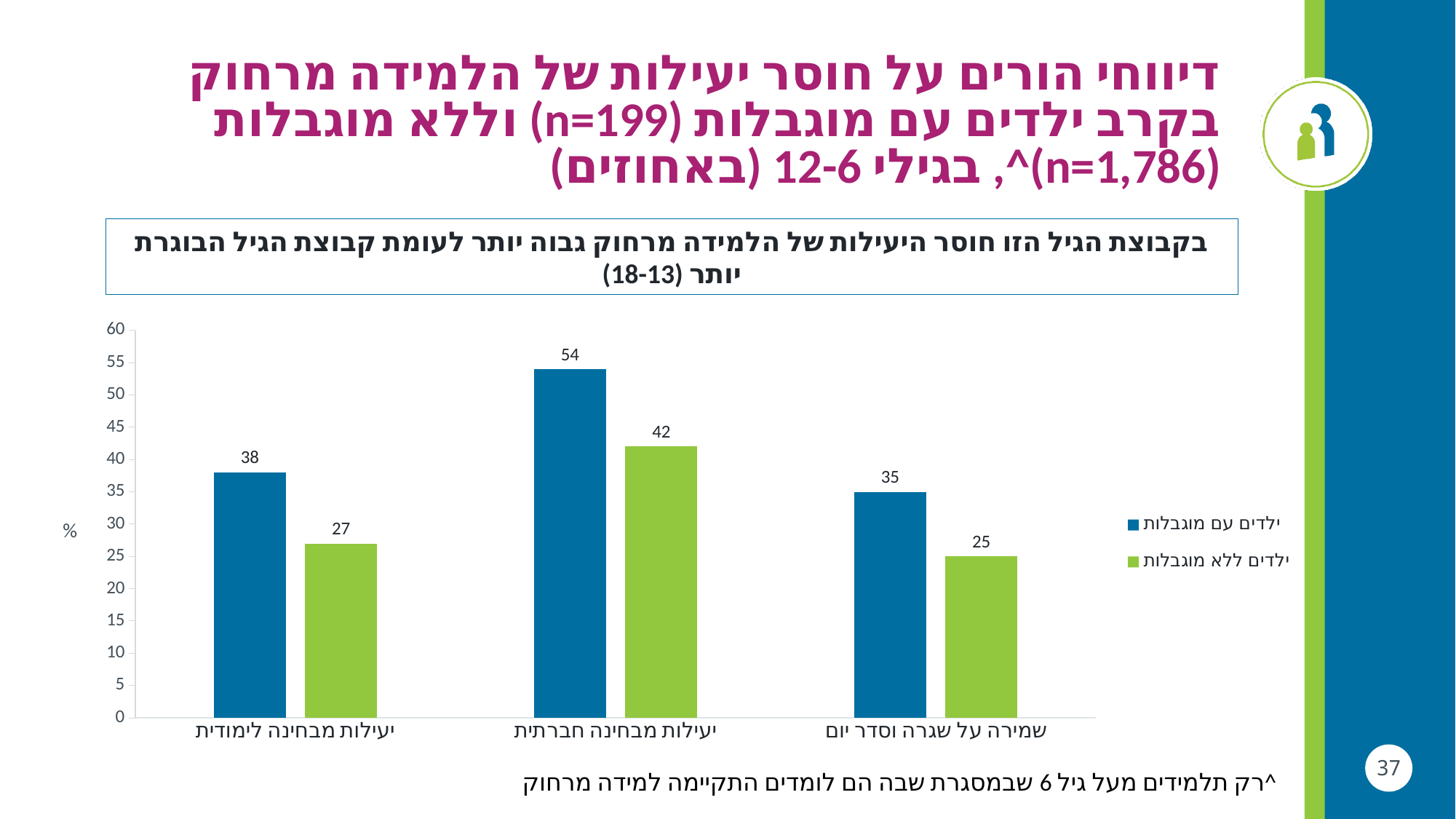
What is the value for ילדים ללא מוגבלות in the category שמירה על שגרה וסדר יום? 25 Which category has the lowest value for ילדים ללא מוגבלות? שמירה על שגרה וסדר יום What is the value for ילדים ללא מוגבלות in the category יעילות מבחינה חברתית? 42 How many categories are shown on the x axis of the chart? 3 In the category שמירה על שגרה וסדר יום, which series has the larger value: ילדים עם מוגבלות or ילדים ללא מוגבלות? ילדים עם מוגבלות What colour are the bars for ילדים ללא מוגבלות? green How many series does the chart's legend list? 2 Which category has the highest value for ילדים עם מוגבלות? יעילות מבחינה חברתית What is the value for ילדים עם מוגבלות in the category יעילות מבחינה לימודית? 38 What is the difference between ילדים עם מוגבלות and ילדים ללא מוגבלות in the category יעילות מבחינה חברתית? 12 Is the value for ילדים עם מוגבלות in יעילות מבחינה חברתית greater or less than 50? greater What kind of chart is shown on the slide? bar chart